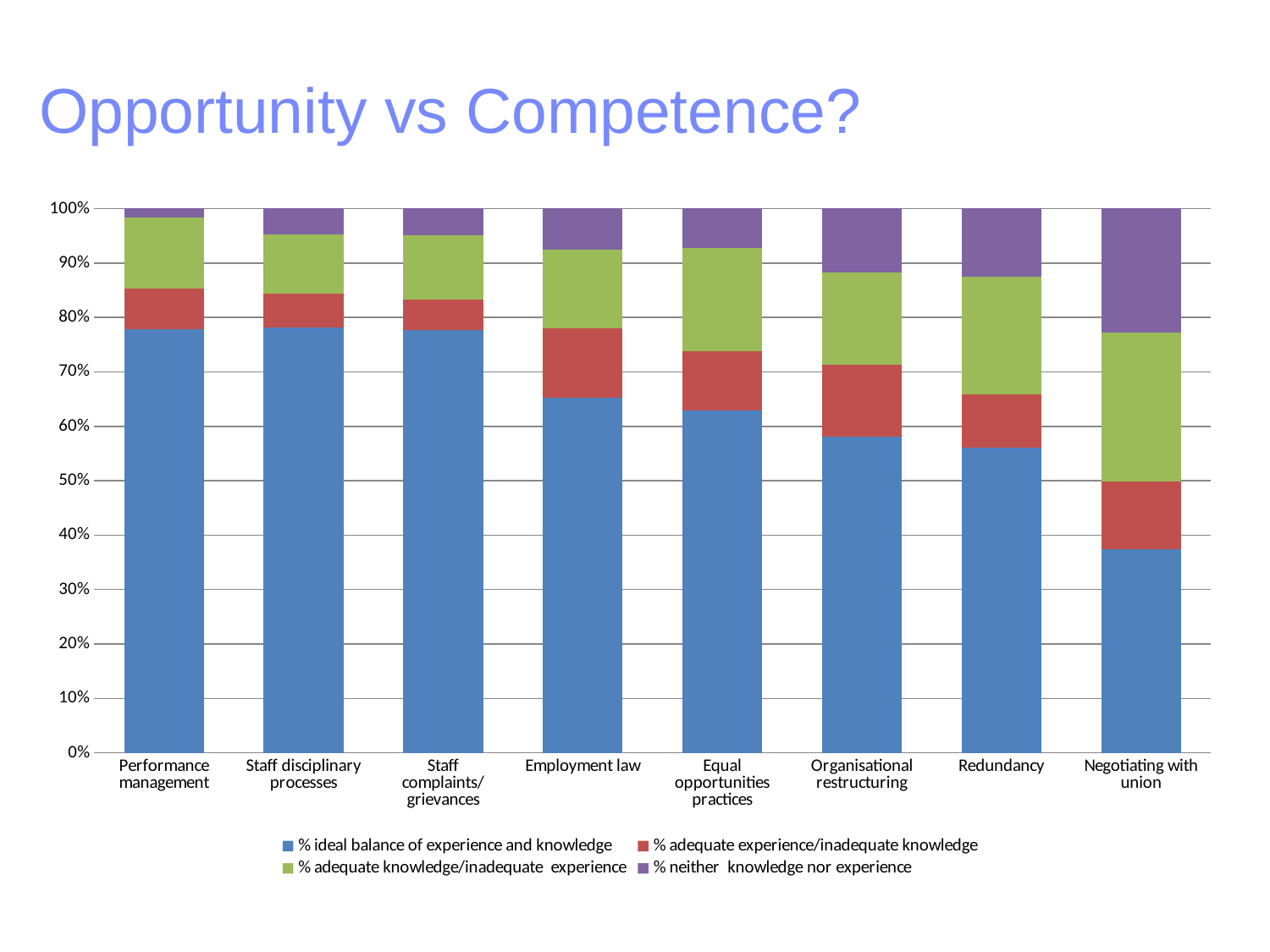
Which has a larger '% ideal balance of experience and knowledge' segment: Employment law or Negotiating with union? Employment law How many series does the legend list? 4 Which category has the smallest '% ideal balance of experience and knowledge' segment? Negotiating with union Which category has the smallest '% neither knowledge nor experience' segment? Performance management Does the '% ideal balance of experience and knowledge' segment generally rise or fall from left to right across the categories? Fall Is the '% ideal balance of experience and knowledge' value for Negotiating with union greater or less than 40%? less What is the title of the slide? Opportunity vs Competence? Is the '% ideal balance of experience and knowledge' value for Redundancy greater or less than 50%? greater Which category has the largest '% neither knowledge nor experience' segment? Negotiating with union What kind of chart is shown on the slide? Stacked bar chart Is the '% ideal balance of experience and knowledge' value for Performance management greater or less than 70%? greater How many categories are shown along the x axis? 8